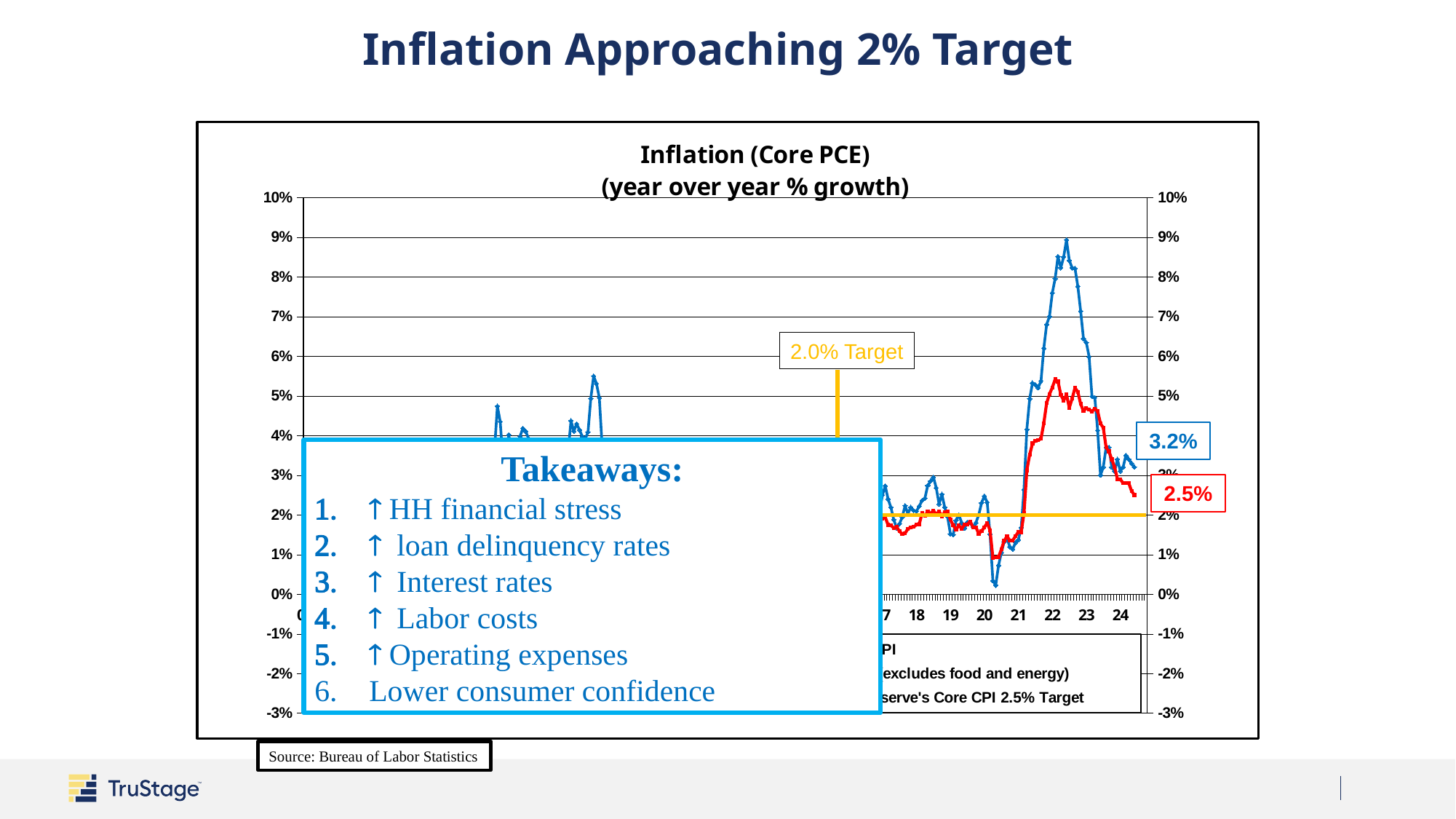
What target level is marked by the yellow horizontal line? 2.0% Target What is the latest value labeled for the blue line? 3.2% From the 2022 peak to 2024, does the blue line rise or fall? fall Is the lowest point of the blue line around 2020 greater or less than 1%? less Is the peak of the blue line around 2022 greater or less than 8%? greater At the end of the series, which line has the higher labeled value, the blue line or the red line? the blue line What is the difference between the labeled end values of the blue line (3.2%) and the red line (2.5%)? 0.7 percentage points What kind of chart is shown on the slide? line chart Is the peak of the red line around 2022 greater or less than 5%? greater What is the latest value labeled for the red line? 2.5% What is the title of the chart? Inflation (Core PCE) (year over year % growth) What is the highest value shown on the y axis? 10%